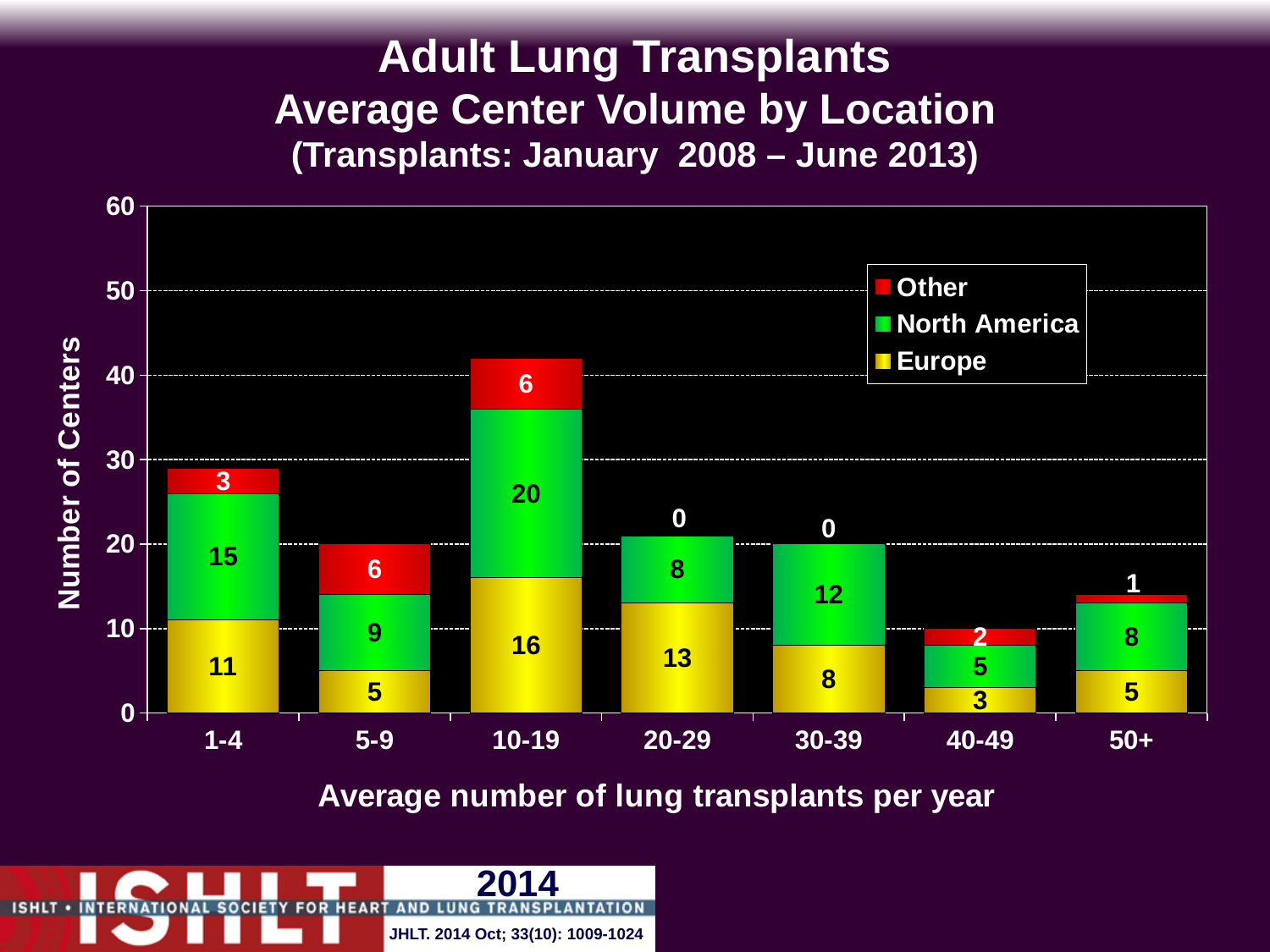
Which is larger in the 1-4 category, the Europe value or the North America value? North America What is the number of Other centers in the 5-9 category? 6 Which category has the lowest number of Europe centers? 40-49 What type of chart is shown on the slide? Stacked bar chart What is the total number of centers in the 1-4 category? 29 How many categories are shown on the x axis? 7 How many series does the legend list? 3 What is the total number of centers in the 10-19 category? 42 What is the number of Europe centers in the 10-19 category? 16 Which category has the highest number of North America centers? 10-19 What is the number of North America centers in the 30-39 category? 12 What is the difference between the Europe and North America values in the 20-29 category? 5